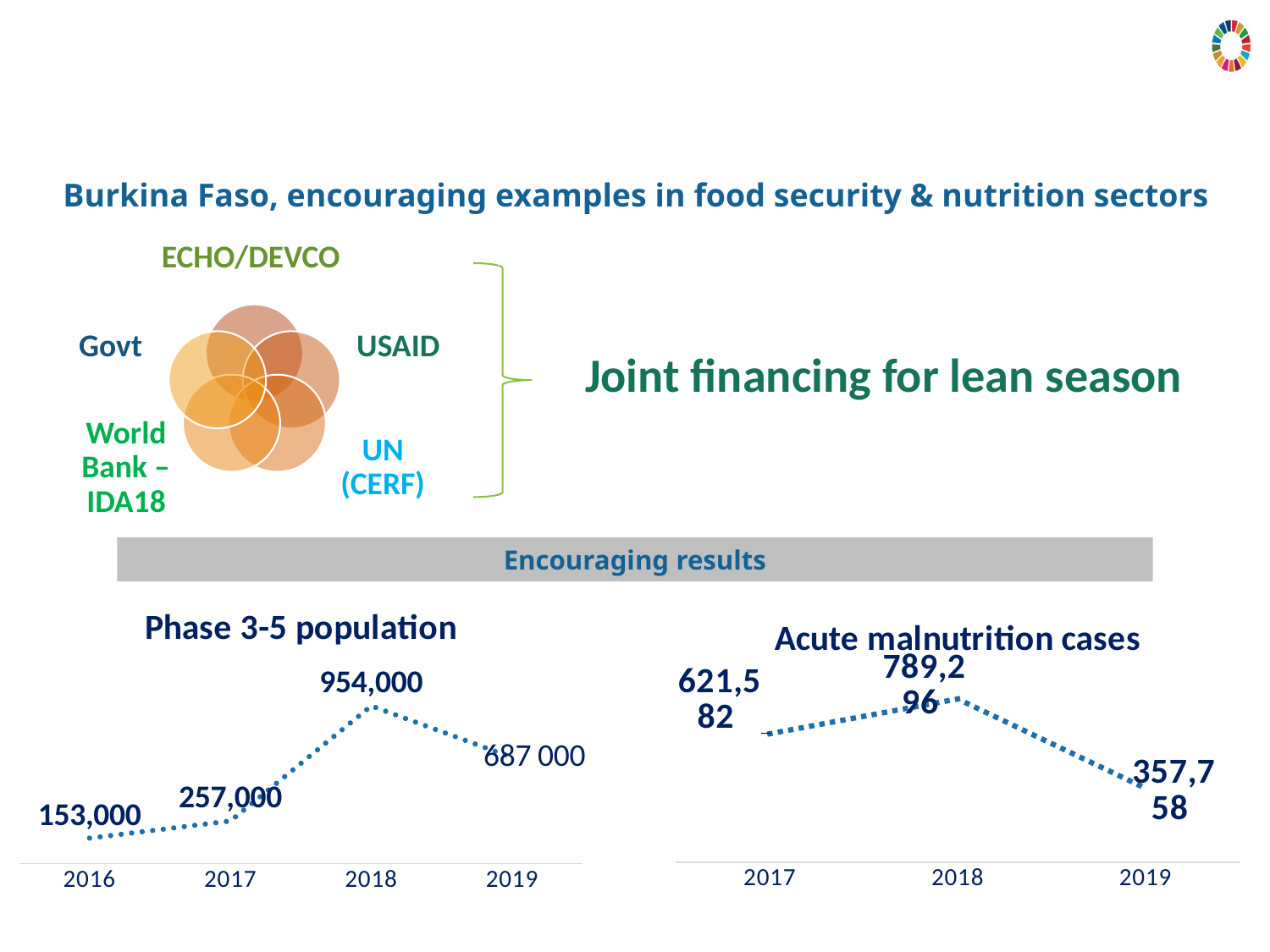
On the Phase 3-5 population chart, which year has the highest value? 2018 On the Acute malnutrition cases chart, what is the value for 2019? 357,758 On the Phase 3-5 population chart, what is the value for 2016? 153,000 On the Phase 3-5 population chart, what is the difference between the 2018 and 2017 values? 697,000 What kind of chart is the Acute malnutrition cases chart? Line chart On the Acute malnutrition cases chart, is the value for 2017 or 2018 larger? 2018 On the Phase 3-5 population chart, what is the value for 2018? 954,000 On the Acute malnutrition cases chart, which year has the lowest value? 2019 On the Phase 3-5 population chart, how many years are plotted? 4 On the Acute malnutrition cases chart, what is the value for 2018? 789,296 On the Phase 3-5 population chart, what is the value for 2019? 687 000 On the Phase 3-5 population chart, which year has the lowest value? 2016